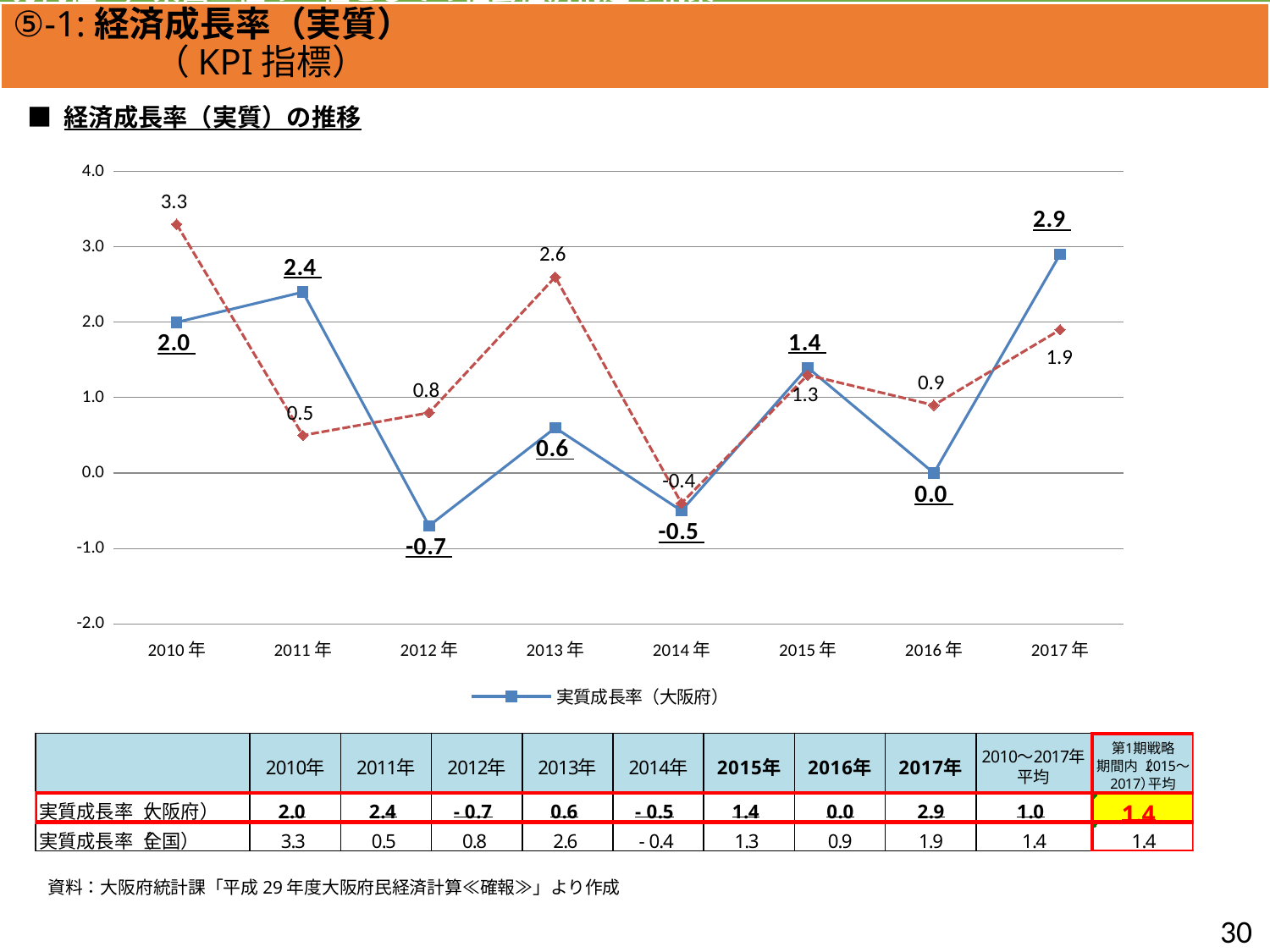
In which year is the 実質成長率（大阪府） value highest? 2017年 What is the difference between the 実質成長率（大阪府） values for 2011年 and 2012年? 3.1 What is the 実質成長率（全国） value for 2013年? 2.6 What type of chart is shown on the slide? line chart Does the 実質成長率（大阪府） line rise or fall from 2016年 to 2017年? rise What is the 実質成長率（大阪府） value for 2012年? -0.7 What is the 実質成長率（大阪府） value for 2017年? 2.9 What is the 実質成長率（全国） value for 2010年? 3.3 In which year is the 実質成長率（大阪府） value lowest? 2012年 How many series does the legend below the chart list? 1 How many years are plotted on the x axis? 8 Which is larger in 2013年, the 大阪府 value or the 全国 value? 全国